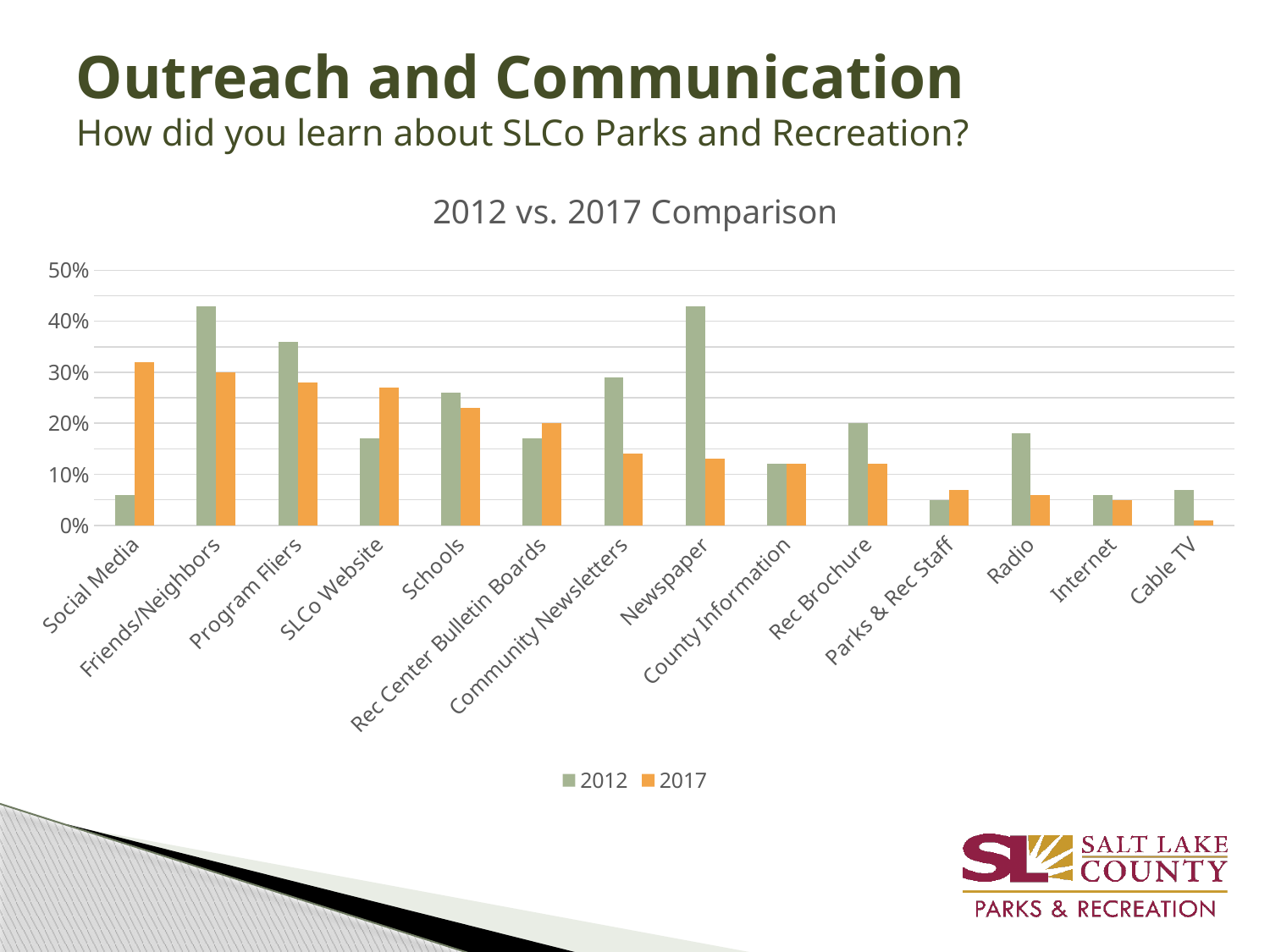
For Social Media, which year has the larger value, 2012 or 2017? 2017 How many series does the legend list? 2 How many categories are shown on the x axis of the chart? 14 Is the 2017 value for Social Media greater or less than 20%? greater For SLCo Website, which year has the larger value, 2012 or 2017? 2017 Is the 2012 value for Newspaper greater or less than 40%? greater Is the 2017 value for Cable TV greater or less than 10%? less What is the title of the chart? 2012 vs. 2017 Comparison Which category has the lowest value for 2017? Cable TV For Newspaper, which year has the larger value, 2012 or 2017? 2012 What kind of chart is shown on the slide? bar chart